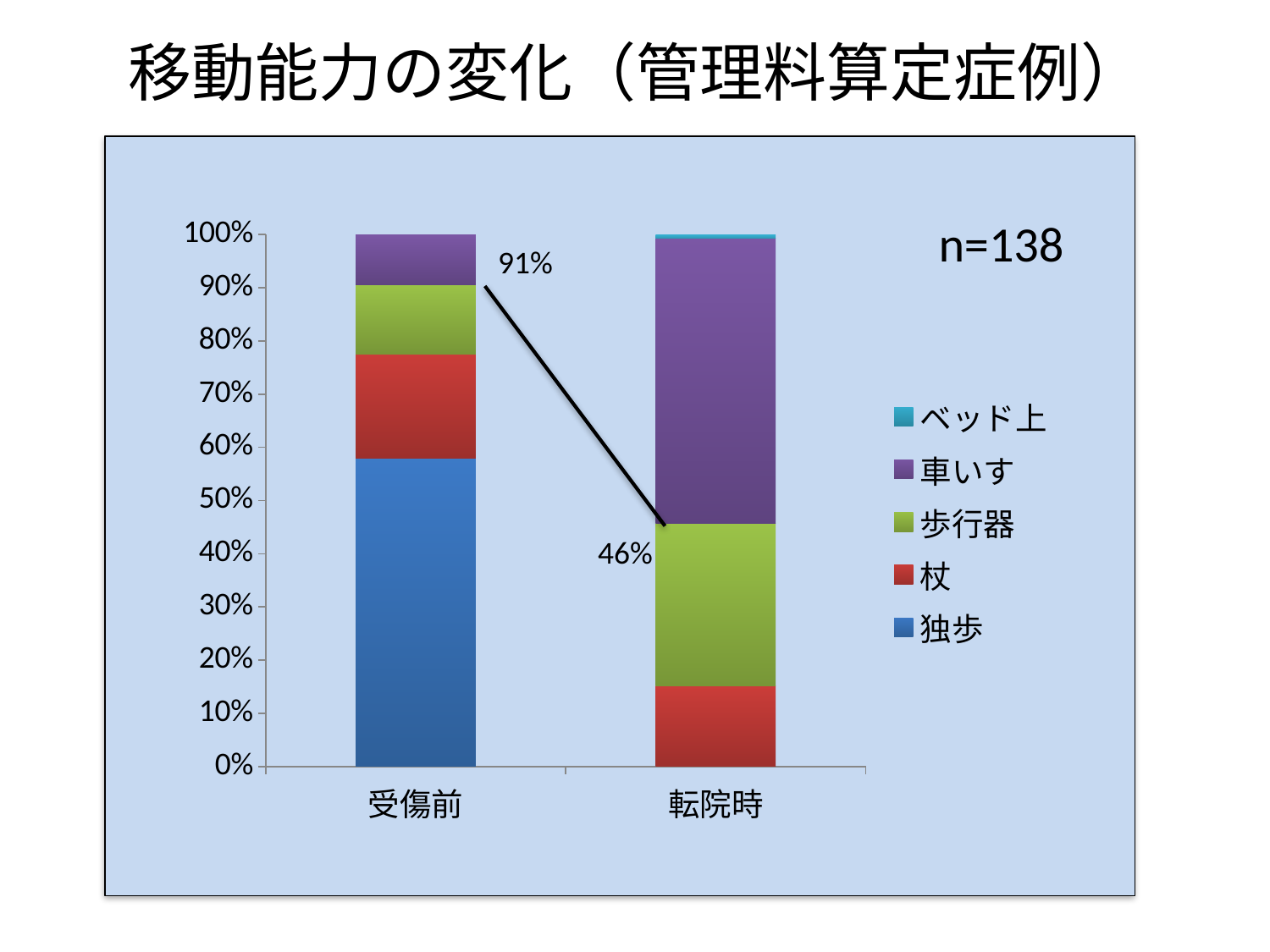
Which bar has the larger 独歩 share, 受傷前 or 転院時? 受傷前 Is the 杖 share in the 転院時 bar greater or less than 20%? less What percentage is annotated next to the 受傷前 bar? 91% What kind of chart is shown on the slide? stacked bar chart Does the 車いす share rise or fall from 受傷前 to 転院時? rise Which legend entry is shown in blue? 独歩 How many categories are shown on the x axis of the chart? 2 How many series does the chart's legend list? 5 What sample size (n) is printed on the chart? n=138 Is the 車いす share in the 転院時 bar greater or less than 40%? greater What percentage is annotated next to the 転院時 bar? 46% Is the 独歩 share in the 受傷前 bar greater or less than 50%? greater